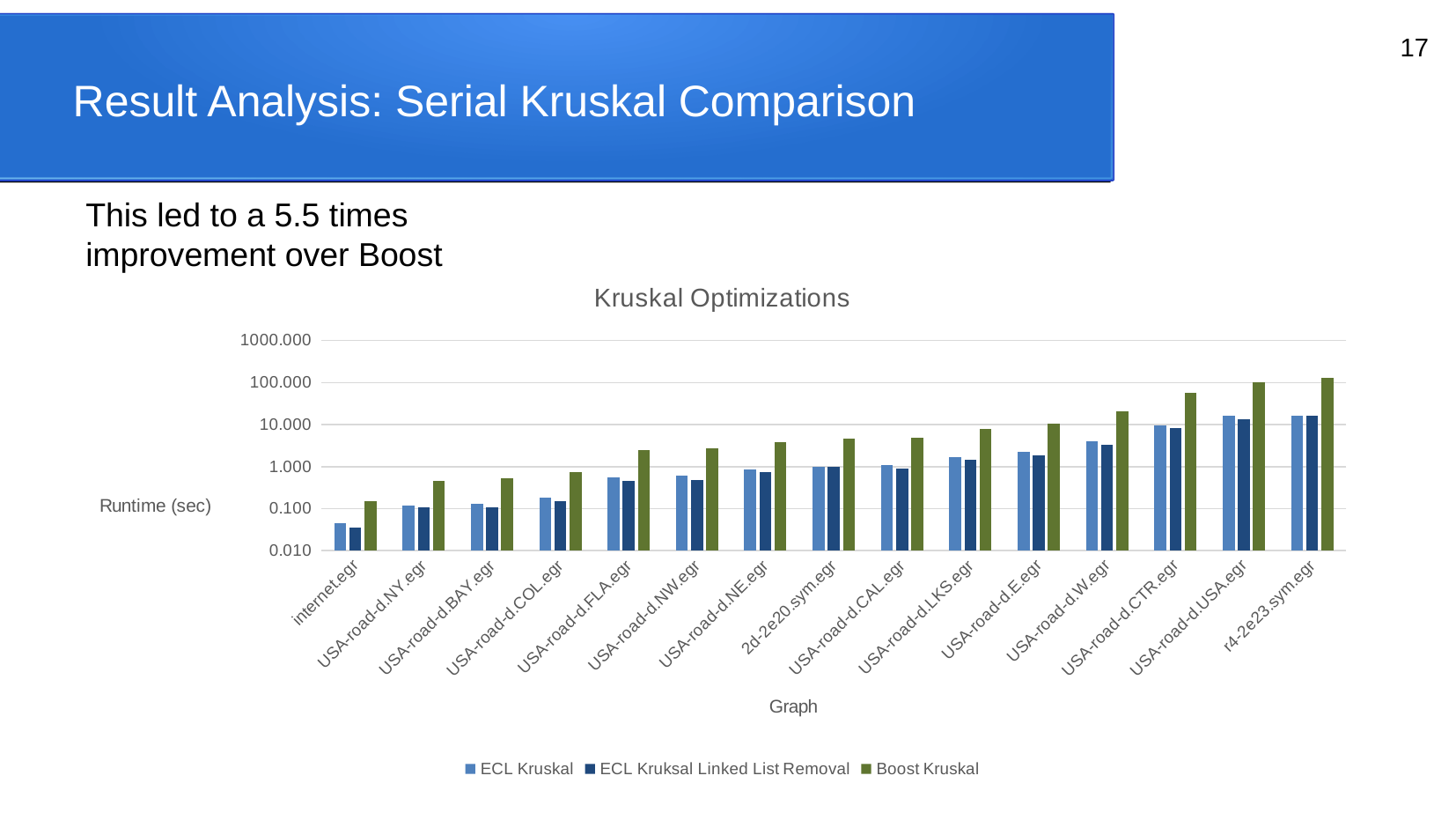
How many graphs (categories) are plotted along the x axis? 15 What is the label of the vertical axis? Runtime (sec) Which graph has the highest Boost Kruskal runtime? r4-2e23.sym.egr Is the Boost Kruskal value for r4-2e23.sym.egr greater or less than 100.000? greater Do the Boost Kruskal runtimes generally rise or fall moving left to right along the x axis? rise For USA-road-d.CTR.egr, which is larger: the Boost Kruskal value or the ECL Kruskal value? Boost Kruskal What is the title of the chart? Kruskal Optimizations What kind of chart is shown on the slide? bar chart Is the ECL Kruskal value for internet.egr greater or less than 0.100? less Is the Boost Kruskal value for USA-road-d.W.egr greater or less than 10.000? greater How many series does the chart's legend list? 3 Which graph has the lowest ECL Kruskal runtime? internet.egr